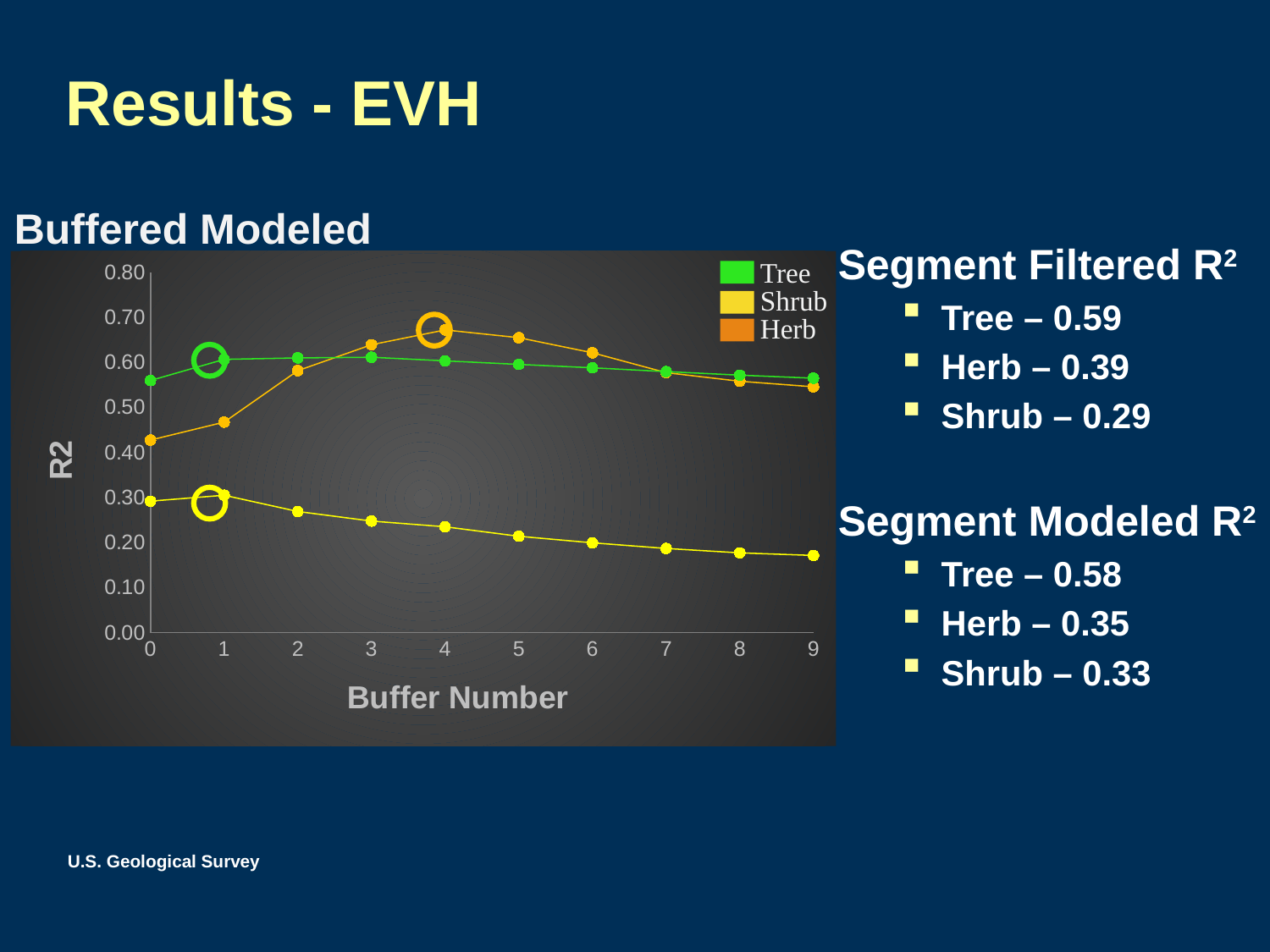
At buffer number 0, which series has the larger value, Tree or Shrub? Tree At which buffer number does the Herb series reach its highest value? 4 How many buffer numbers are plotted along the x axis for each series? 10 Is the Herb value at buffer number 4 greater or less than 0.60? greater What kind of chart is shown on the slide? line chart At buffer number 4, which series has the larger value, Herb or Tree? Herb Is the Herb value at buffer number 0 greater or less than 0.50? less What is the label of the chart's x axis? Buffer Number What are the series names listed in the chart's legend? Tree, Shrub, Herb Does the Shrub series rise or fall from buffer number 1 to buffer number 9? fall Is the Shrub value at buffer number 9 greater or less than 0.20? less How many series does the chart's legend list? 3